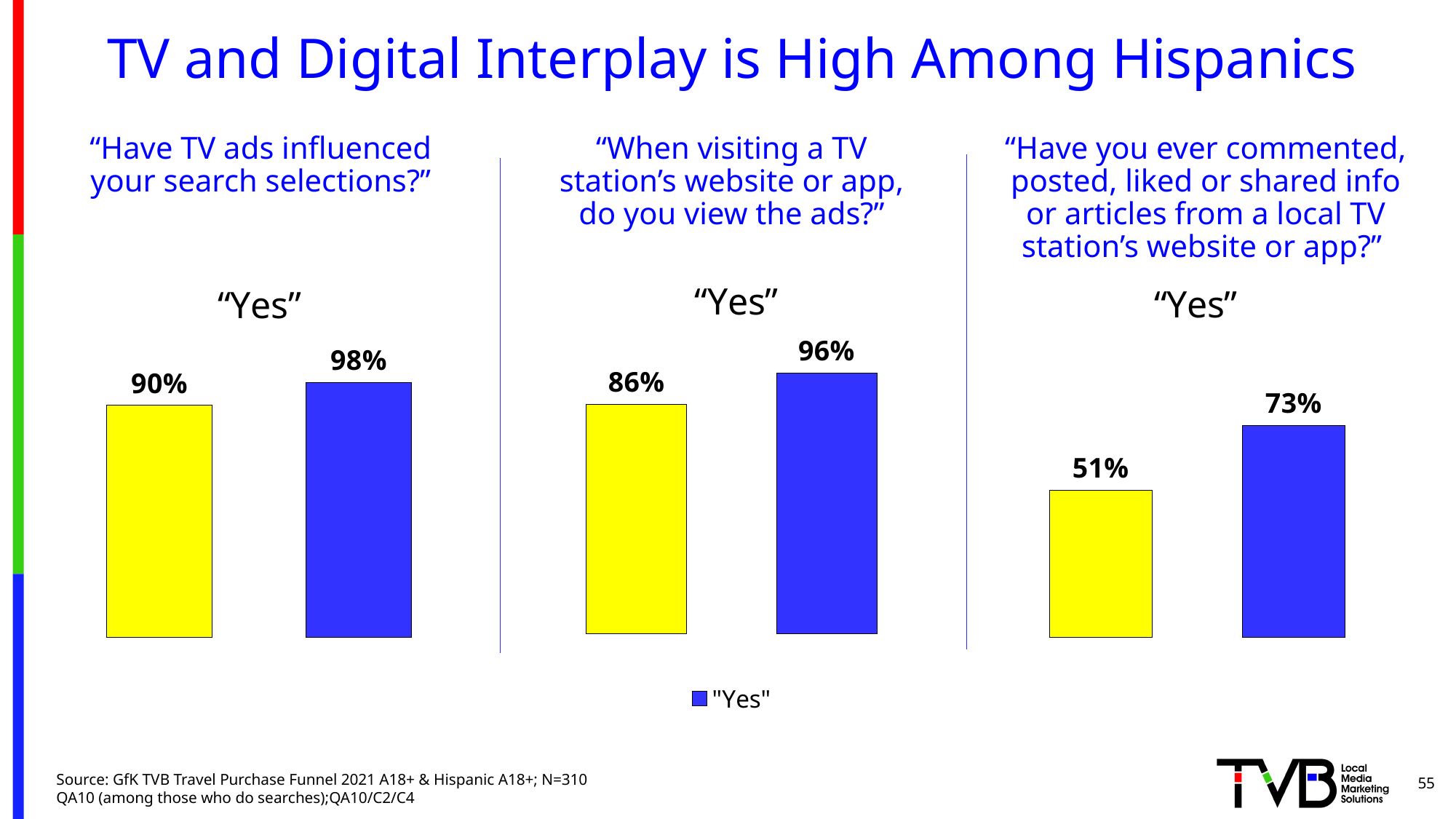
What entry does the legend at the bottom of the slide list? "Yes" In the left chart, what is the difference between the blue bar and the yellow bar? 8% In the left chart ("Have TV ads influenced your search selections?"), what value is shown on the blue bar? 98% In the right chart, what is the difference between the blue bar and the yellow bar? 22% In the right chart ("Have you ever commented, posted, liked or shared info or articles from a local TV station's website or app?"), what value is shown on the blue bar? 73% In the middle chart, which bar is larger, the yellow bar or the blue bar? the blue bar What kind of chart is used in the middle chart? bar chart In the middle chart ("When visiting a TV station's website or app, do you view the ads?"), what value is shown on the yellow bar? 86% In the right chart ("Have you ever commented, posted, liked or shared info or articles from a local TV station's website or app?"), what value is shown on the yellow bar? 51% How many bars are plotted in the right chart? 2 In the middle chart ("When visiting a TV station's website or app, do you view the ads?"), what value is shown on the blue bar? 96% In the left chart ("Have TV ads influenced your search selections?"), what value is shown on the yellow bar? 90%